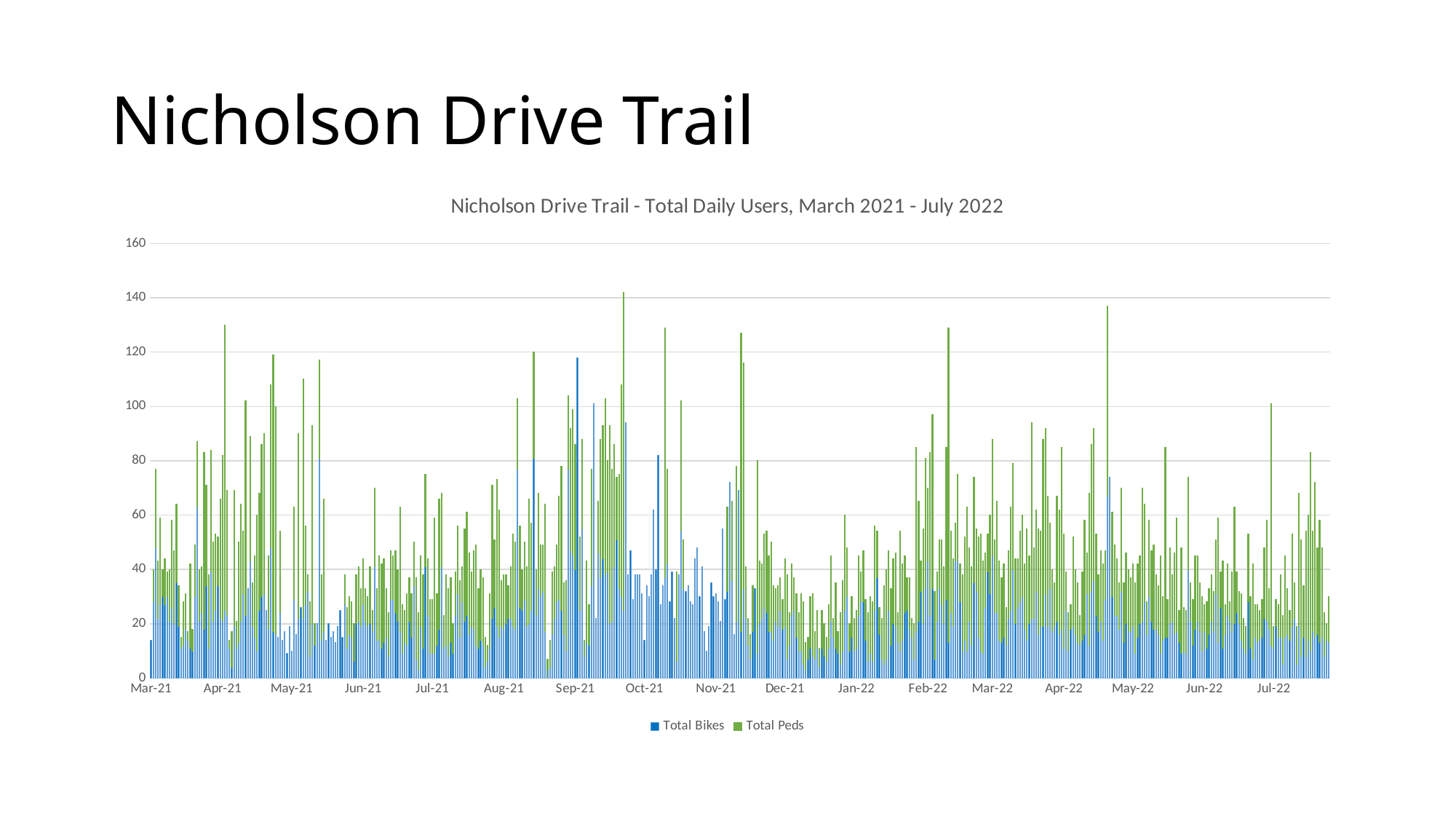
How many month labels are shown along the horizontal axis? 17 Is the tallest Total Bikes bar greater or less than 140? less What kind of chart is shown on the slide? bar chart Which two series are listed in the legend? Total Bikes and Total Peds What is the last month label on the horizontal axis? Jul-22 What is the title of the chart? Nicholson Drive Trail - Total Daily Users, March 2021 - July 2022 Is the tallest Total Bikes bar greater or less than 100? greater How many series does the legend list? 2 What is the first month label on the horizontal axis? Mar-21 What is the highest value shown on the vertical axis? 160